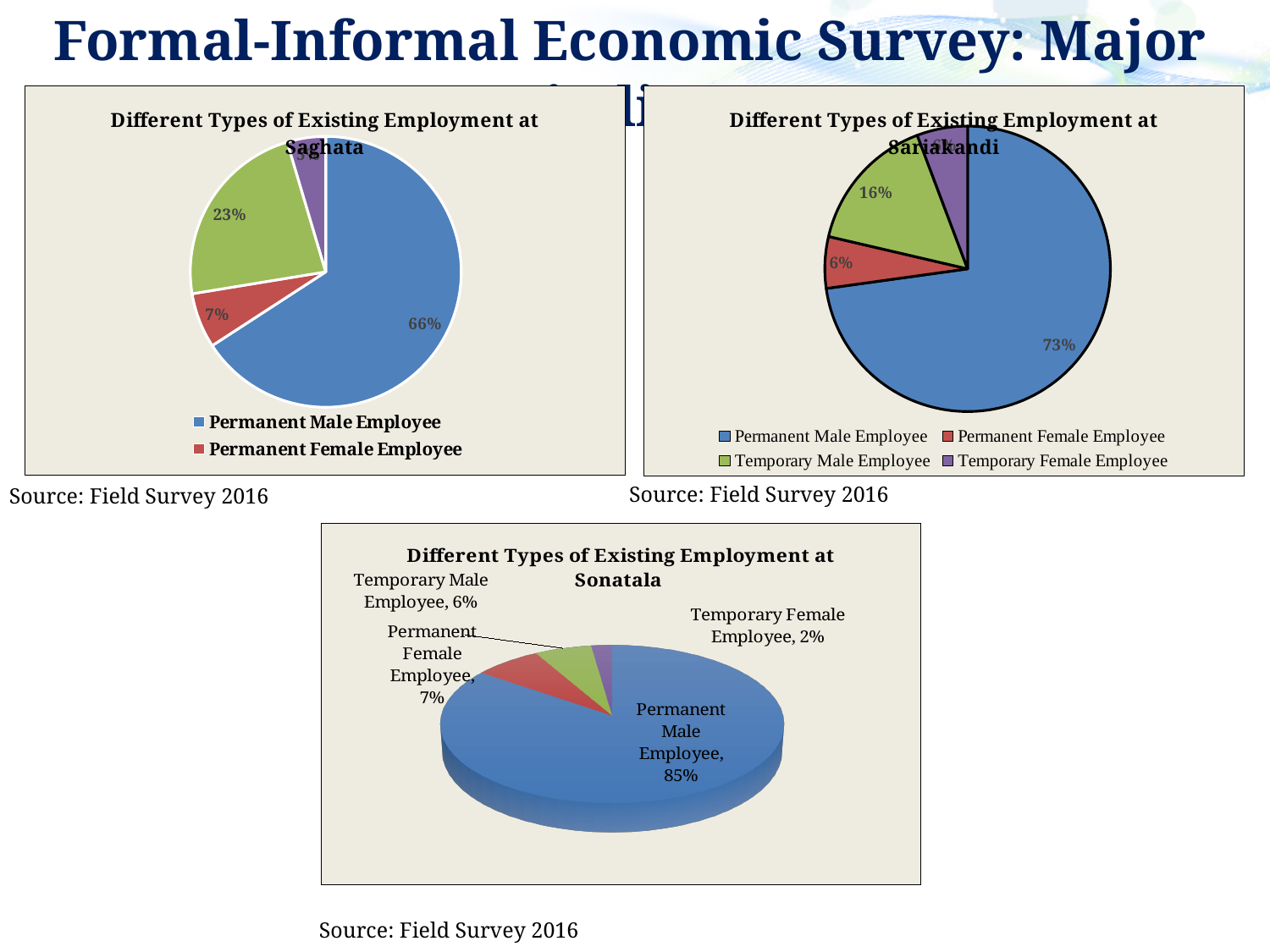
In the pie chart titled 'Different Types of Existing Employment at Sariakandi', what percentage is shown for Permanent Female Employee? 6% In the pie chart titled 'Different Types of Existing Employment at Sonatala', which is larger: Permanent Female Employee or Temporary Male Employee? Permanent Female Employee What kind of chart is the chart titled 'Different Types of Existing Employment at Sonatala'? Pie chart In the pie chart titled 'Different Types of Existing Employment at Sonatala', what percentage is shown for Permanent Male Employee? 85% How many entries does the legend of the pie chart titled 'Different Types of Existing Employment at Sariakandi' list? 4 In the pie chart titled 'Different Types of Existing Employment at Sariakandi', what is the difference in percentage points between Permanent Male Employee and Temporary Male Employee? 57 percentage points In the pie chart titled 'Different Types of Existing Employment at Saghata', what percentage is shown for Permanent Female Employee? 7% In the pie chart titled 'Different Types of Existing Employment at Sonatala', which category has the smallest slice? Temporary Female Employee In the pie chart titled 'Different Types of Existing Employment at Sariakandi', what percentage is shown for Permanent Male Employee? 73% In the pie chart titled 'Different Types of Existing Employment at Saghata', what percentage is shown for Permanent Male Employee? 66% In the pie chart titled 'Different Types of Existing Employment at Sonatala', what percentage is shown for Temporary Female Employee? 2% In the pie chart titled 'Different Types of Existing Employment at Sariakandi', what percentage is shown for Temporary Male Employee? 16%